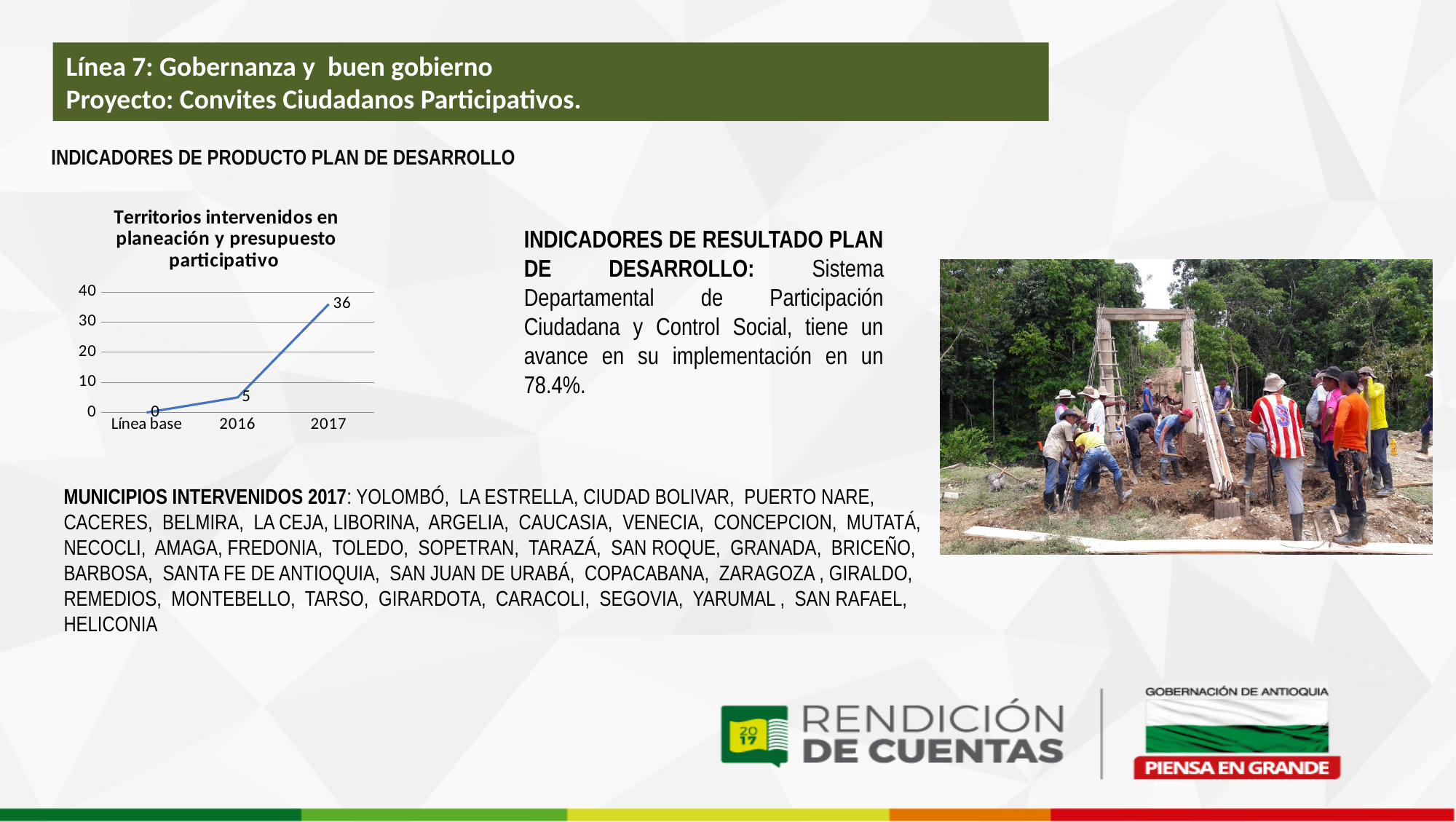
What is the value for 2016 in the chart? 5 Is the value for 2017 greater or less than 30? greater Which category has the lowest value in the chart? Línea base What is the title of the chart? Territorios intervenidos en planeación y presupuesto participativo What is the value for 2017 in the chart? 36 What is the value for Línea base in the chart? 0 How many data points are plotted in the chart? 3 What is the difference between the values for 2017 and 2016? 31 Which category has the highest value in the chart? 2017 What kind of chart is shown on the slide? line chart Do the values rise or fall from Línea base to 2017? rise Which is larger, the value for 2016 or the value for 2017? 2017